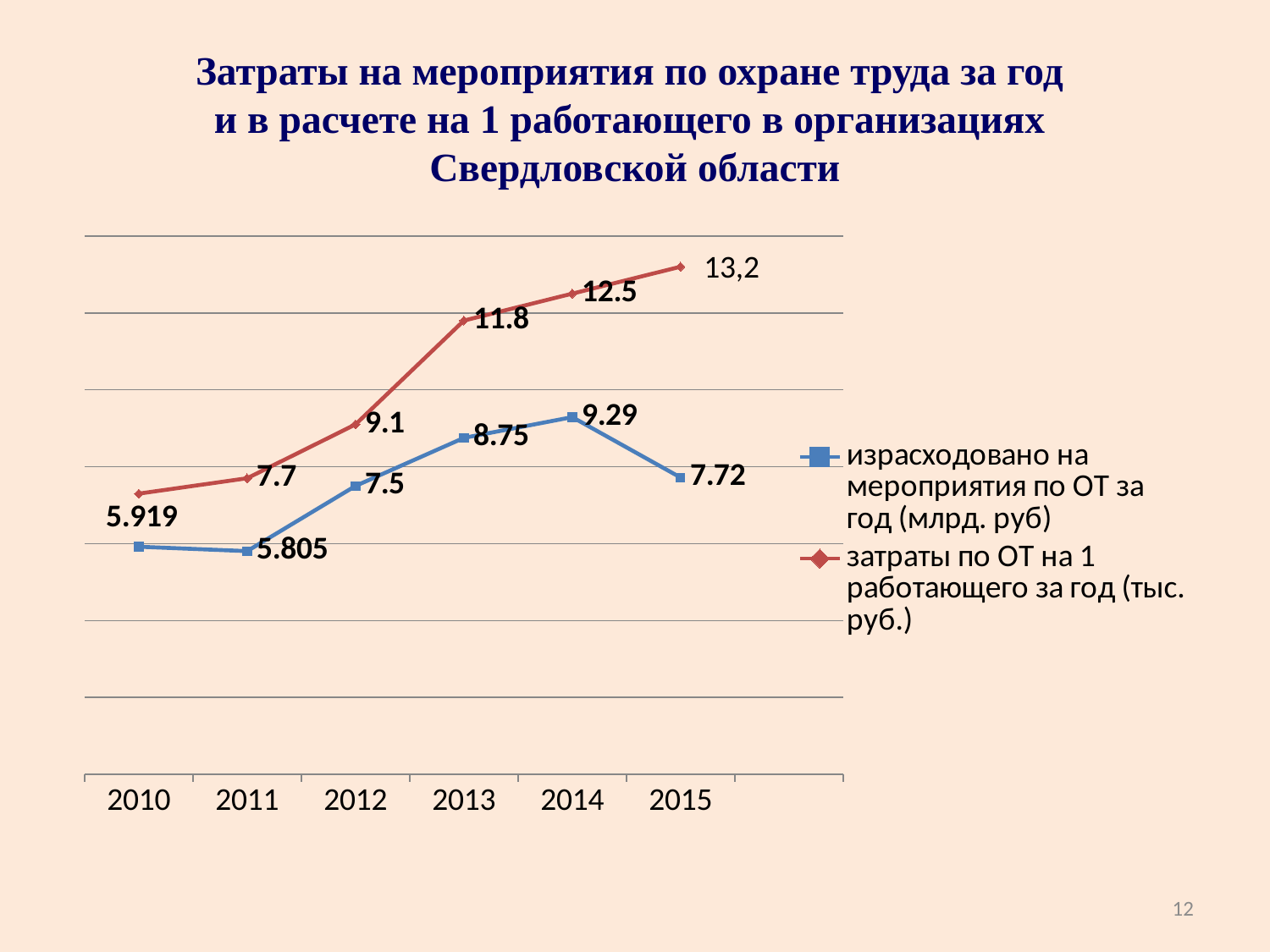
What type of chart is shown on the slide? line chart In which year is 'израсходовано на мероприятия по ОТ за год (млрд. руб)' lowest? 2011 What is the value of 'израсходовано на мероприятия по ОТ за год (млрд. руб)' in 2010? 5.919 What colour is the line for 'затраты по ОТ на 1 работающего за год (тыс. руб.)'? red Does 'затраты по ОТ на 1 работающего за год (тыс. руб.)' rise or fall from 2010 to 2015? rise Which is larger for 'затраты по ОТ на 1 работающего за год (тыс. руб.)': the 2012 value or the 2013 value? 2013 What is the value of 'затраты по ОТ на 1 работающего за год (тыс. руб.)' in 2015? 13,2 In which year is 'израсходовано на мероприятия по ОТ за год (млрд. руб)' highest? 2014 How many years are shown on the x axis? 6 How many series does the legend list? 2 What is the difference between the 2014 and 2015 values of 'израсходовано на мероприятия по ОТ за год (млрд. руб)'? 1.57 What is the value of 'израсходовано на мероприятия по ОТ за год (млрд. руб)' in 2013? 8.75